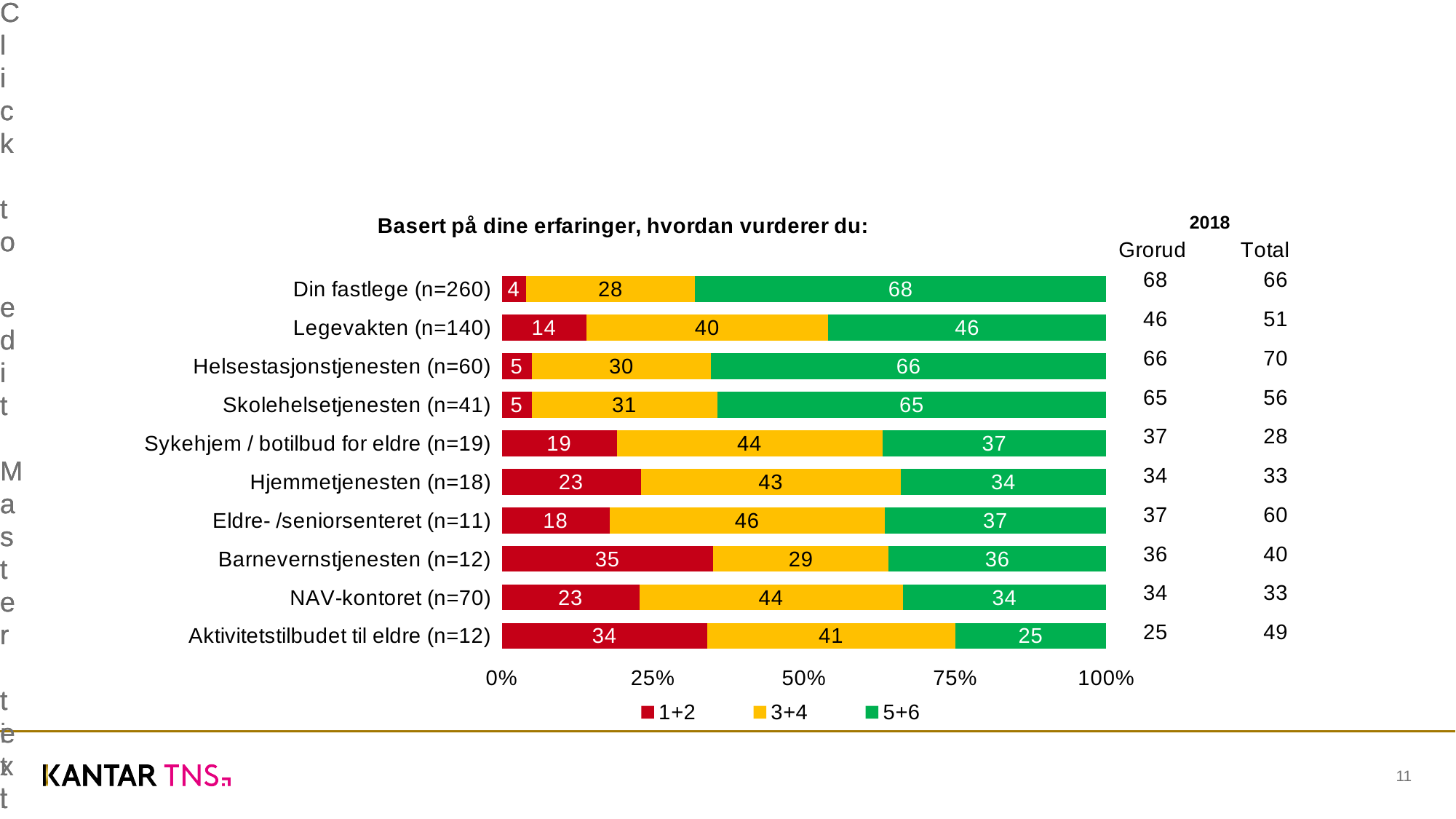
Which category has the lowest 5+6 value? Aktivitetstilbudet til eldre (n=12) What is the total of the stacked bar for Skolehelsetjenesten (n=41)? 101 How many categories (services) are plotted in the chart? 10 Which is larger: the 1+2 value for Sykehjem / botilbud for eldre (n=19) or the 1+2 value for NAV-kontoret (n=70)? NAV-kontoret (n=70) What is the 5+6 value for Din fastlege (n=260)? 68 What is the 3+4 value for Eldre- /seniorsenteret (n=11)? 46 Which category has the highest 5+6 value? Din fastlege (n=260) What is the difference between the 5+6 value for Legevakten (n=140) and the 5+6 value for Hjemmetjenesten (n=18)? 12 How many series does the legend list? 3 What type of chart is shown on the slide? Stacked bar chart What is the 1+2 value for Barnevernstjenesten (n=12)? 35 What is the title of the chart? Basert på dine erfaringer, hvordan vurderer du: